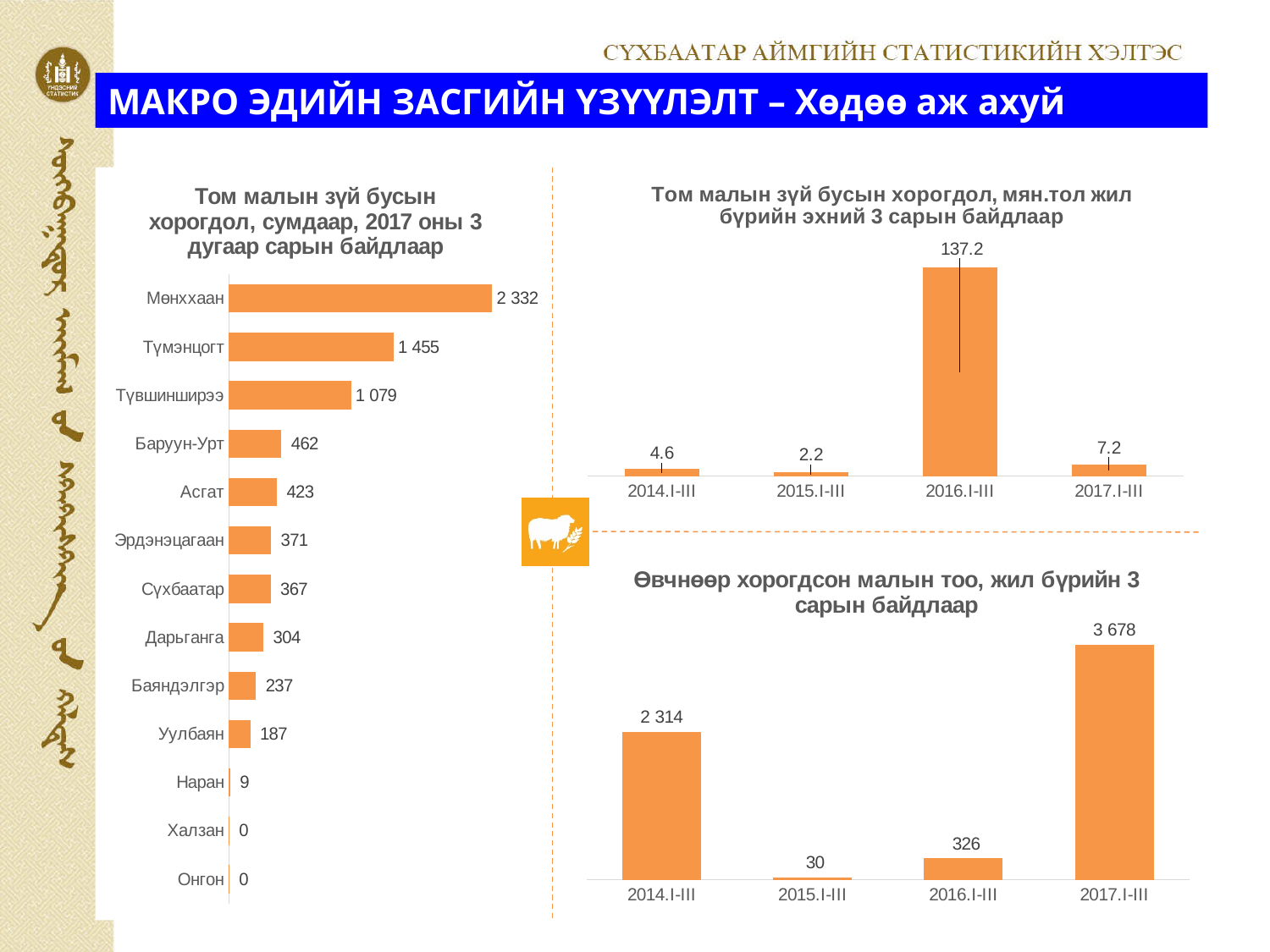
In the bottom-right chart (Өвчнөөр хорогдсон малын тоо), what is the value for 2017.I-III? 3 678 In the top-right chart (Том малын зүй бусын хорогдол, мян.тол), what is the value for 2016.I-III? 137.2 In the top-right chart (Том малын зүй бусын хорогдол, мян.тол), what is the difference between 2017.I-III and 2014.I-III? 2.6 What kind of chart is the left chart (Том малын зүй бусын хорогдол, сумдаар)? Bar chart In the left chart (Том малын зүй бусын хорогдол, сумдаар), which category has the highest value? Мөнххаан In the left chart (Том малын зүй бусын хорогдол, сумдаар), what is the value for Мөнххаан? 2 332 In the left chart (Том малын зүй бусын хорогдол, сумдаар), how many categories are shown? 13 In the bottom-right chart (Өвчнөөр хорогдсон малын тоо), which period has the lowest value? 2015.I-III In the top-right chart (Том малын зүй бусын хорогдол, мян.тол), which period has the lowest value? 2015.I-III In the left chart (Том малын зүй бусын хорогдол, сумдаар), which is larger, Баруун-Урт or Асгат? Баруун-Урт In the left chart (Том малын зүй бусын хорогдол, сумдаар), what is the difference between Түмэнцогт and Түвшинширээ? 376 In the bottom-right chart (Өвчнөөр хорогдсон малын тоо), what is the difference between 2017.I-III and 2014.I-III? 1 364